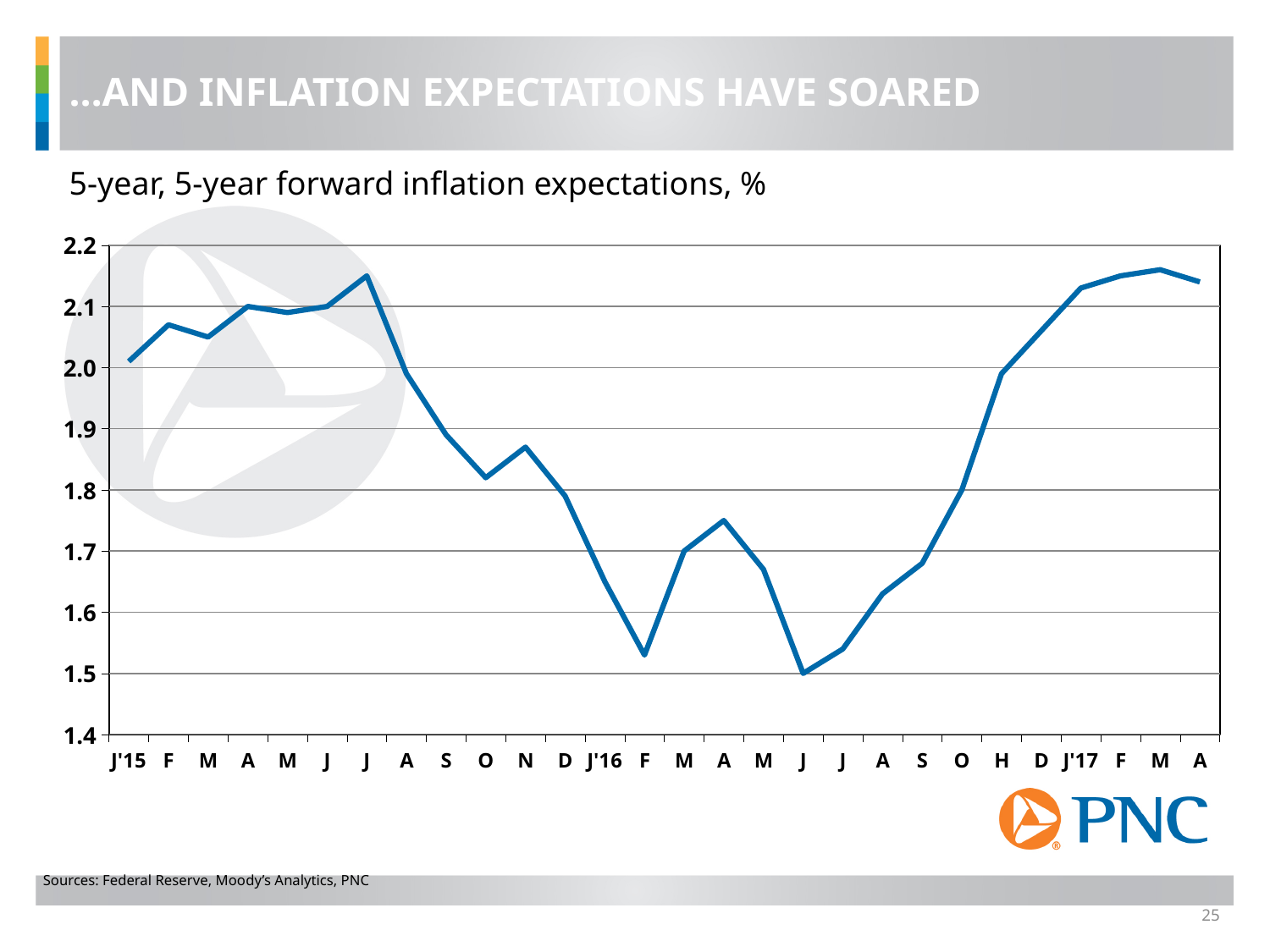
Which month has the lowest value on the chart? J (June) 2016 What is the value for June 2016, the lowest point on the chart? 1.5 Is the value for D (December) 2016 greater or less than 2.0? greater Which is larger, the value for J'15 (January 2015) or the value for A (April) 2017? A (April) 2017 What kind of chart is shown on the slide? line chart What is the title of the chart? 5-year, 5-year forward inflation expectations, % How many monthly data points are plotted on the chart? 28 Do the values rise or fall from J'15 (January 2015) to F (February) 2016? fall Is the value for F (February) 2016 greater or less than 1.6? less Do the values rise or fall from J (June) 2016 to M (March) 2017? rise